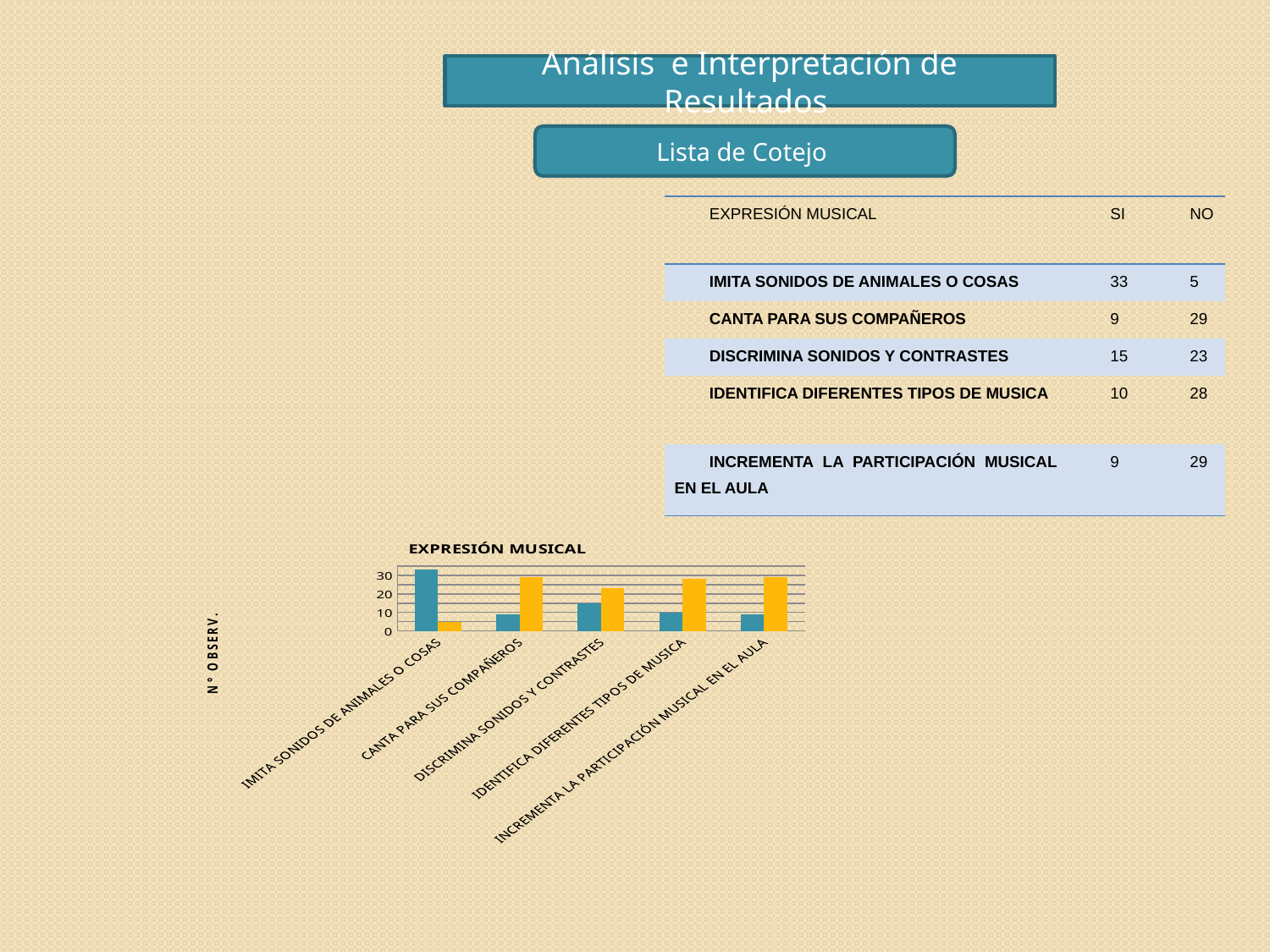
Is the yellow bar for CANTA PARA SUS COMPAÑEROS greater or less than 20? greater What is the label on the vertical axis of the chart? N° OBSERV. What is the title of the chart? EXPRESIÓN MUSICAL According to the table, what is the difference between the NO and SI values for IDENTIFICA DIFERENTES TIPOS DE MUSICA? 18 Which category has the tallest blue bar in the chart? IMITA SONIDOS DE ANIMALES O COSAS What kind of chart is shown on the slide? bar chart According to the table, what is the SI value for IMITA SONIDOS DE ANIMALES O COSAS? 33 Is the blue bar for IDENTIFICA DIFERENTES TIPOS DE MUSICA greater or less than 20? less Is the blue bar for IMITA SONIDOS DE ANIMALES O COSAS greater or less than 30? greater Which category has the shortest yellow bar in the chart? IMITA SONIDOS DE ANIMALES O COSAS For DISCRIMINA SONIDOS Y CONTRASTES, which bar is taller, the blue one or the yellow one? the yellow one How many categories are plotted along the x axis of the chart? 5